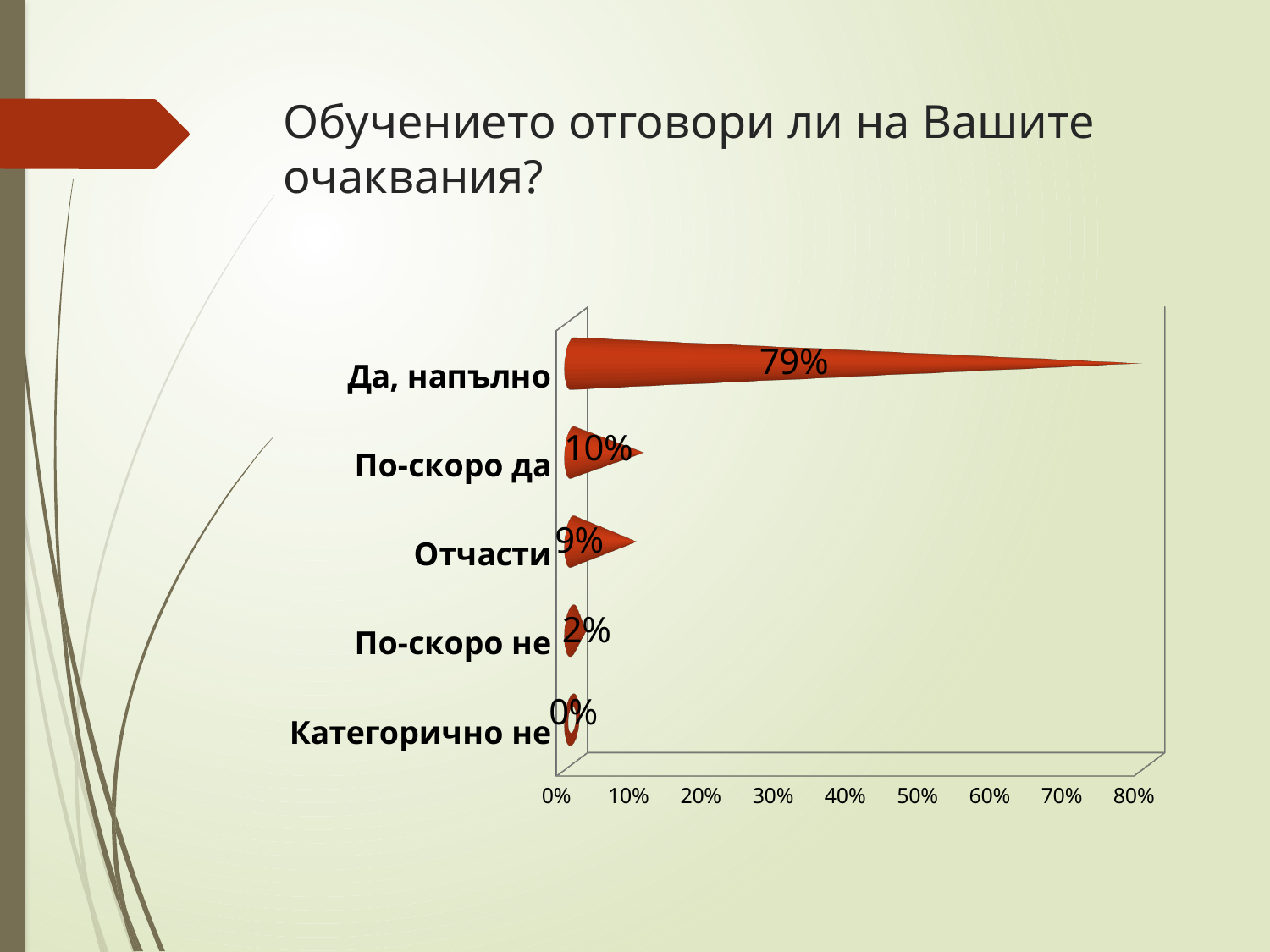
What is the title of the slide? Обучението отговори ли на Вашите очаквания? What is the difference between the values for "Да, напълно" and "По-скоро да"? 69% What is the value for "По-скоро не"? 2% How many categories are shown in the chart? 5 Which is larger, the value for "Отчасти" or the value for "По-скоро не"? Отчасти Which category has the highest value? Да, напълно What is the value for "Отчасти"? 9% What kind of chart is shown on the slide? Bar chart What is the value for "По-скоро да"? 10% What is the value for "Категорично не"? 0% What is the value for "Да, напълно"? 79% Which category has the lowest value? Категорично не